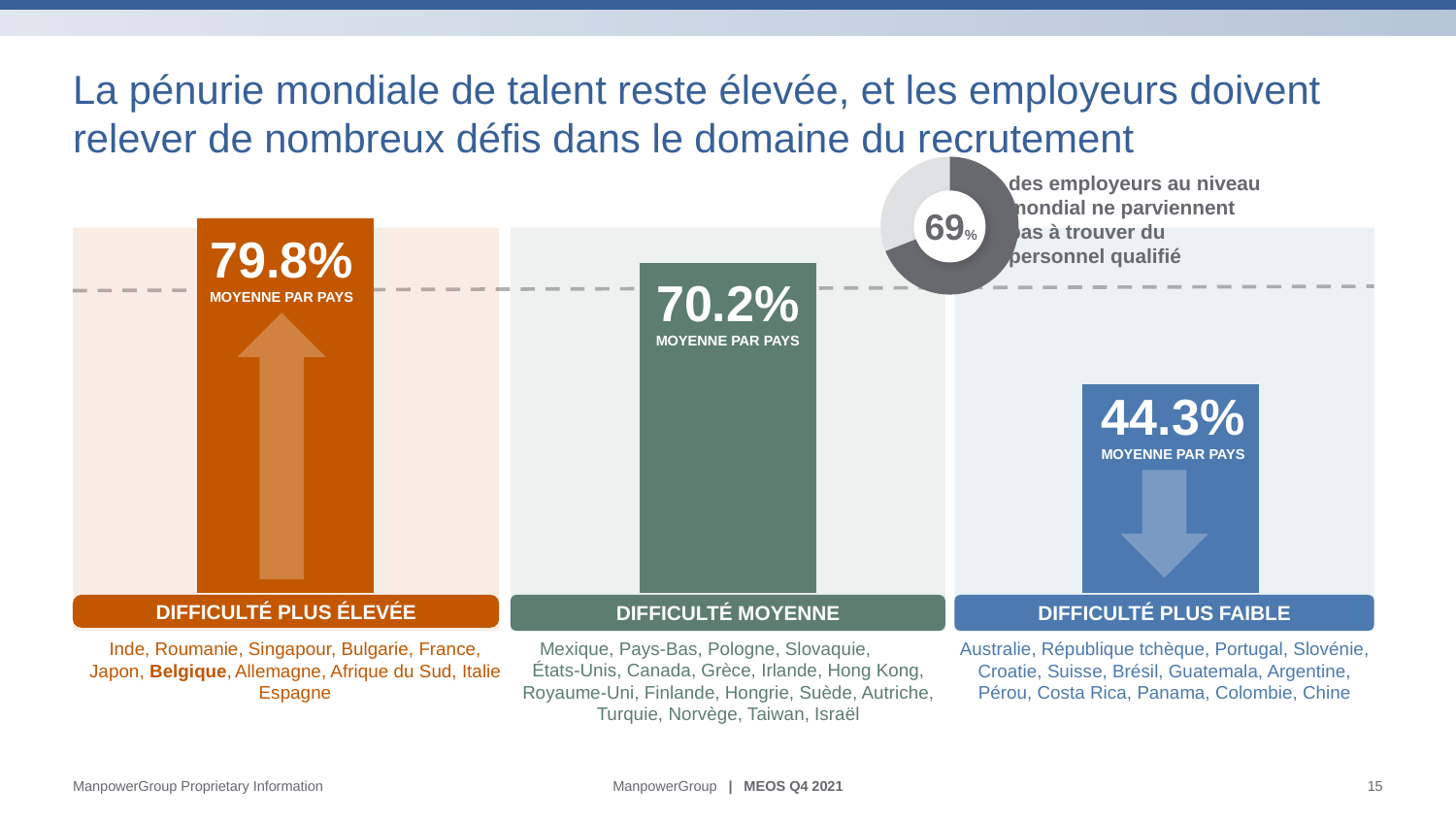
What is the difference between the averages for 'Difficulté plus élevée' and 'Difficulté moyenne'? 9.6 percentage points What is the difference between the averages for 'Difficulté plus élevée' and 'Difficulté plus faible'? 35.5 percentage points What is the average per country (moyenne par pays) shown for the 'Difficulté plus élevée' group? 79.8% Which is larger, the average for 'Difficulté moyenne' or for 'Difficulté plus faible'? Difficulté moyenne Which difficulty group has the lowest average per country? Difficulté plus faible What is the average per country shown for the 'Difficulté plus faible' group? 44.3% How many difficulty groups are shown as bars on the slide? 3 What kind of chart is the small chart at the top right of the slide? Donut (pie) chart What share of employers worldwide does the small donut chart at the top right show as unable to find qualified staff? 69% What is the average per country shown for the 'Difficulté moyenne' group? 70.2% Which difficulty group has the highest average per country? Difficulté plus élevée What colour is the bar for the 'Difficulté plus élevée' group? Orange